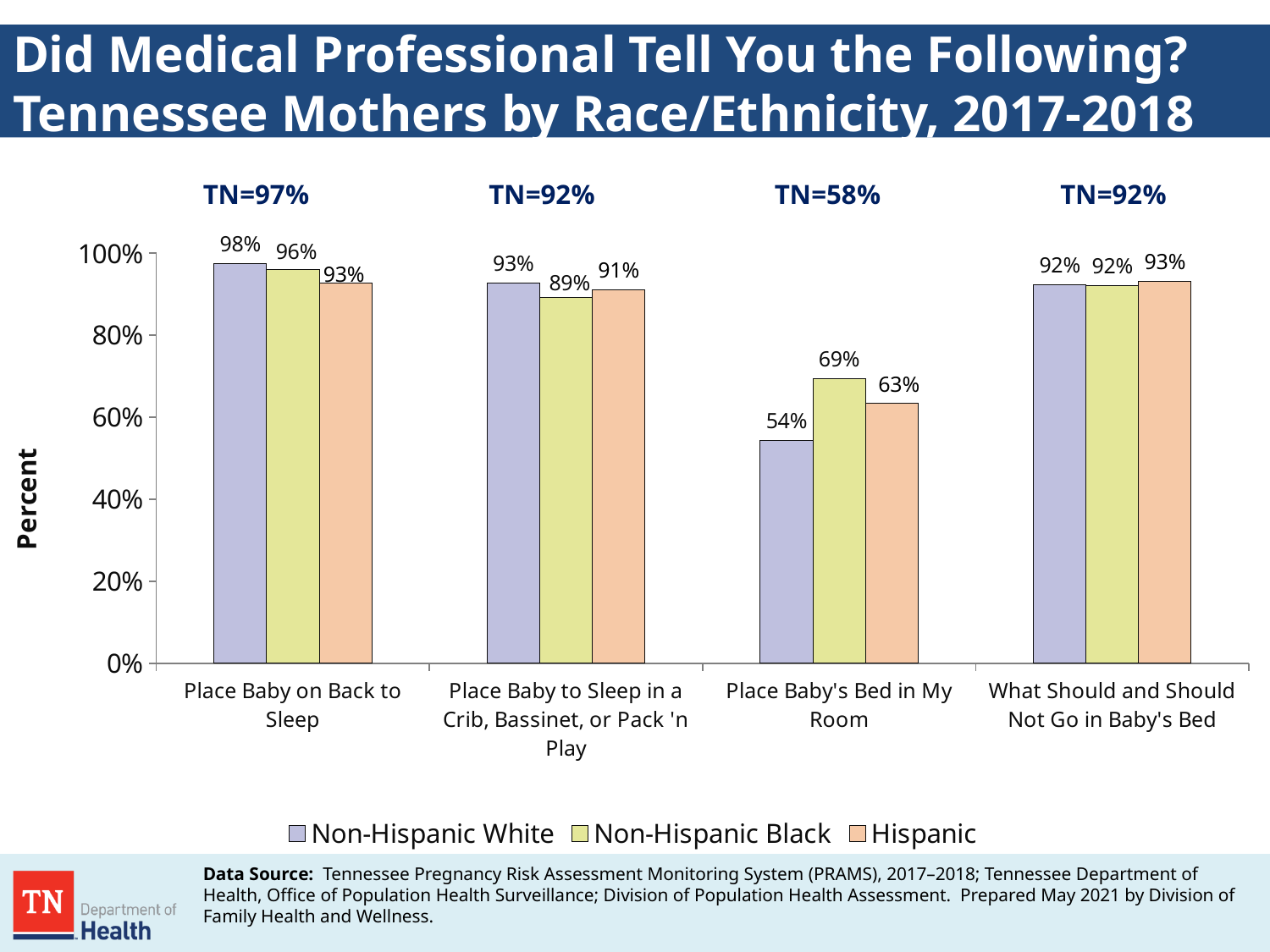
Which race/ethnicity group has the lowest value for 'Place Baby on Back to Sleep'? Hispanic How many series does the legend list? 3 How many categories are shown on the x axis? 4 What is the difference between the Non-Hispanic Black and Non-Hispanic White values for 'Place Baby's Bed in My Room'? 15% What percentage of Non-Hispanic White mothers were told to place baby on back to sleep? 98% Is the Non-Hispanic White value for 'Place Baby's Bed in My Room' greater or less than 60%? less What kind of chart is shown on the slide? bar chart What is the value for Non-Hispanic Black mothers for 'Place Baby to Sleep in a Crib, Bassinet, or Pack 'n Play'? 89% What is the value for Hispanic mothers for 'Place Baby's Bed in My Room'? 63% What is the overall Tennessee percentage shown above the 'Place Baby's Bed in My Room' category? TN=58% Which race/ethnicity group has the highest value for 'Place Baby's Bed in My Room'? Non-Hispanic Black For 'Place Baby to Sleep in a Crib, Bassinet, or Pack 'n Play', which is larger: the Non-Hispanic White value or the Hispanic value? Non-Hispanic White